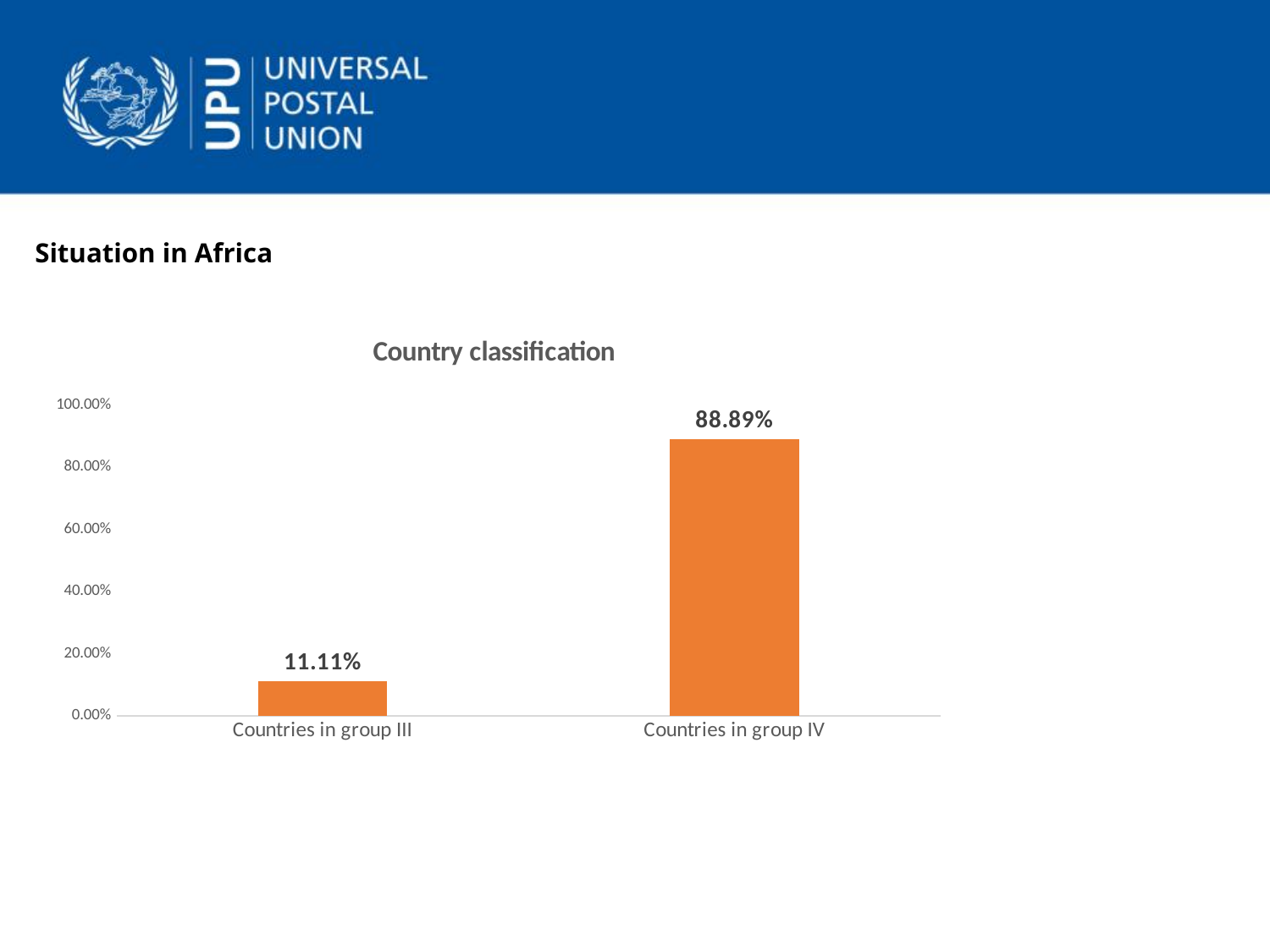
What is the value for Countries in group III? 11.11% Which is larger, the value for Countries in group III or Countries in group IV? Countries in group IV Which category has the lowest value? Countries in group III What is the title of the chart? Country classification How many categories are shown in the chart? 2 What is the value for Countries in group IV? 88.89% Is the value for Countries in group III greater or less than 20.00%? less What is the total of the two values shown in the chart? 100.00% What kind of chart is shown on the slide? bar chart Is the value for Countries in group IV greater or less than 80.00%? greater What is the difference between the values for Countries in group IV and Countries in group III? 77.78% Which category has the highest value? Countries in group IV